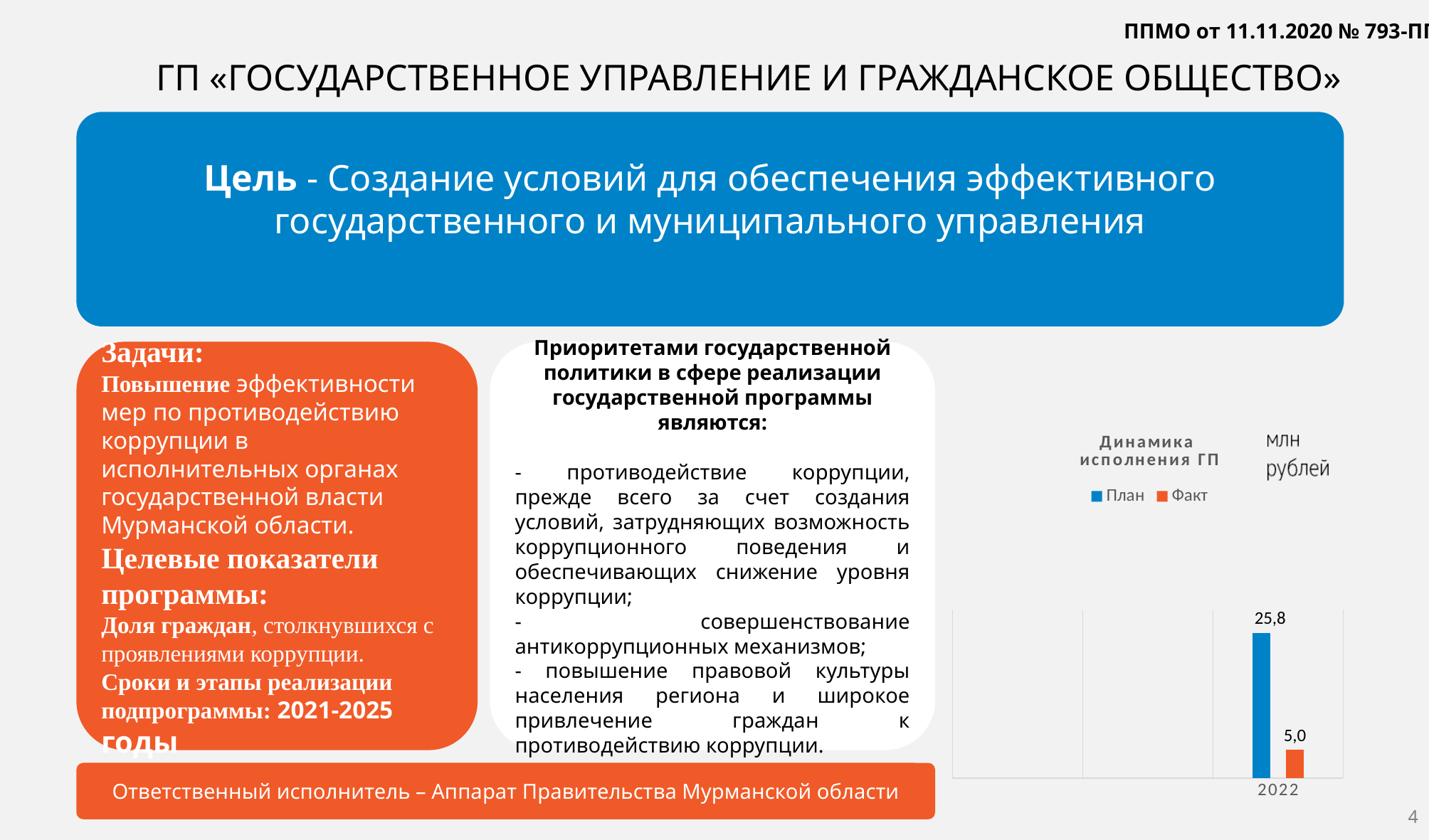
What is the title of the chart? Динамика исполнения ГП What is the value of План for 2022? 25,8 What is the difference between План and Факт for 2022? 20,8 What kind of chart is shown on the slide? Bar chart Which year is shown on the x axis of the chart? 2022 What colour are the Факт bars in the chart? Orange Which series has the higher value for 2022, План or Факт? План How many series does the chart legend list? 2 What unit is indicated next to the chart title? млн рублей How many categories are shown on the x axis of the chart? 1 What is the value of Факт for 2022? 5,0